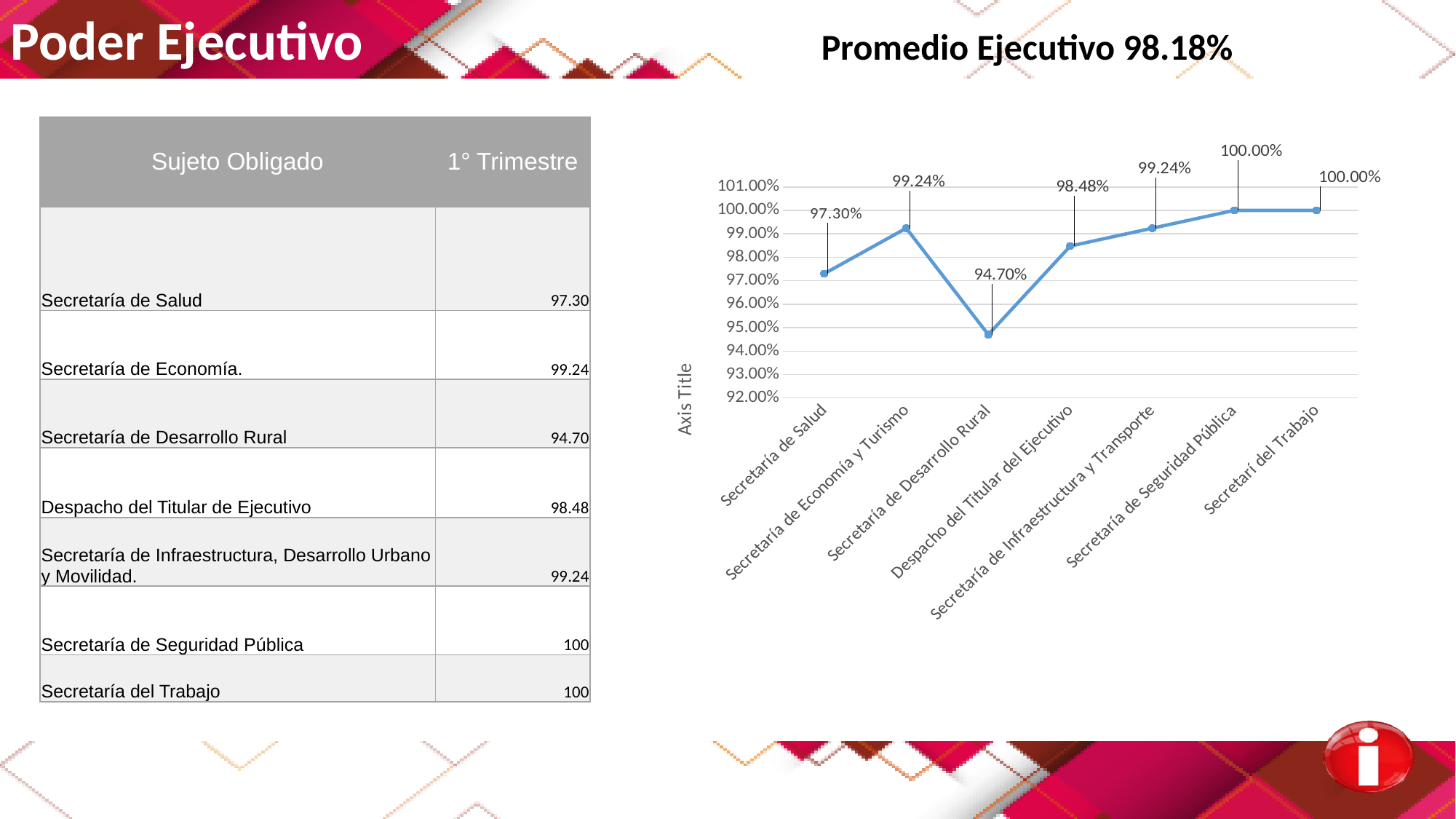
Is the value for Secretaría de Desarrollo Rural greater or less than 96.00%? less What is the value for Despacho del Titular del Ejecutivo in the chart? 98.48% What is the value for Secretaría de Salud in the chart? 97.30% What is the value for Secretaría de Desarrollo Rural in the chart? 94.70% Which is larger, the value for Secretaría de Salud or the value for Despacho del Titular del Ejecutivo? Despacho del Titular del Ejecutivo How many data points are plotted in the chart? 7 What is the label shown on the vertical axis of the chart? Axis Title What type of chart is shown on the slide? line chart Does the line rise or fall between Secretaría de Desarrollo Rural and Secretaría de Seguridad Pública? rise Which category has the lowest value in the chart? Secretaría de Desarrollo Rural What is the value for Secretaría de Seguridad Pública in the chart? 100.00% What is the difference between the values for Secretaría de Economía y Turismo and Secretaría de Desarrollo Rural? 4.54%